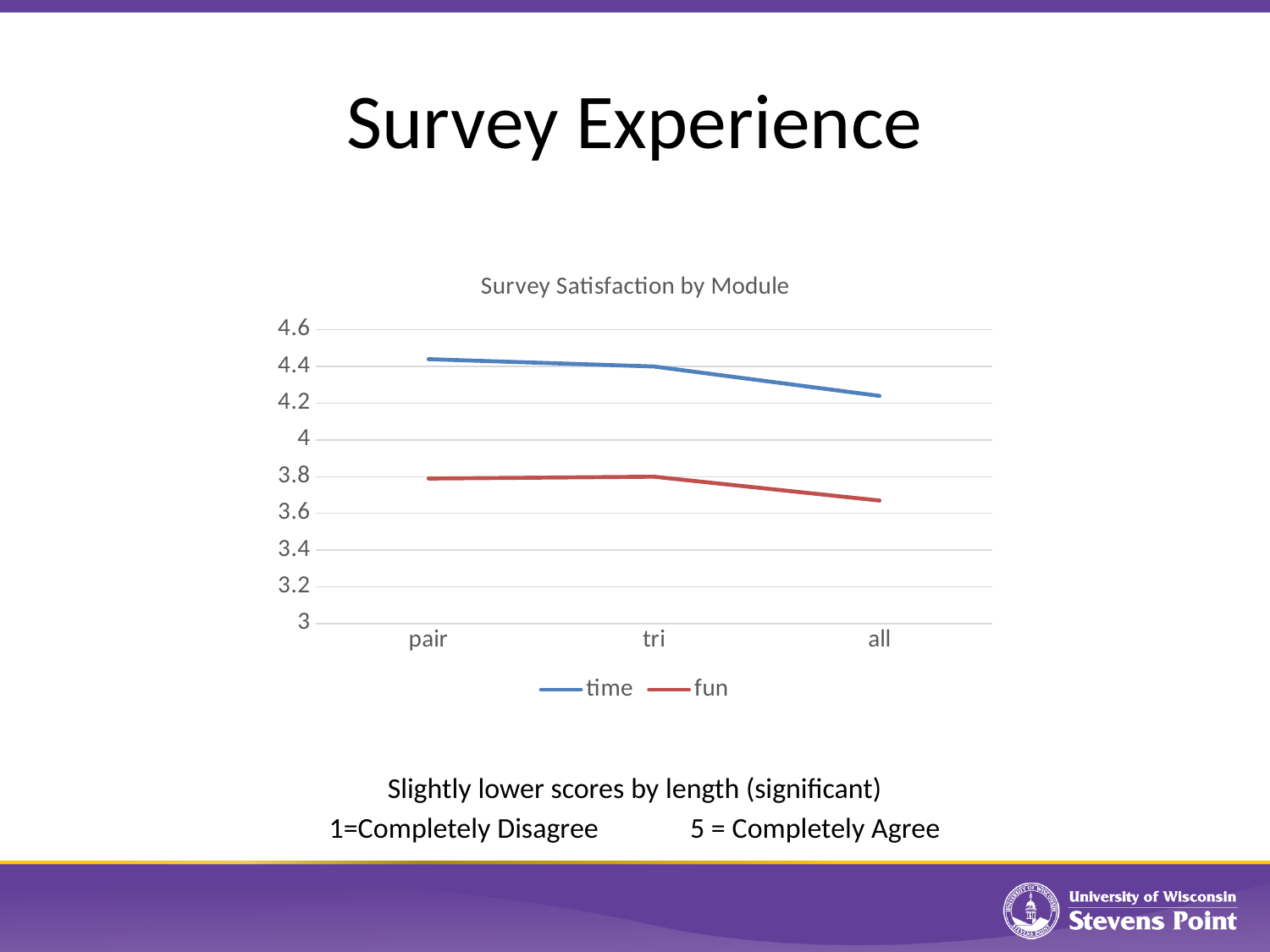
At the category all, which series has the larger value, time or fun? time Which series is drawn in red? fun For which category is the time series lowest? all What kind of chart is shown on the slide? line chart Is the value for time at all greater or less than 4.4? less Is the value for fun at all greater or less than 3.8? less How many series does the legend list? 2 What is the title of the chart? Survey Satisfaction by Module Does the time series rise or fall from pair to all? fall Is the value for fun at pair greater or less than 4? less How many categories are shown on the x axis? 3 For which category is the fun series lowest? all